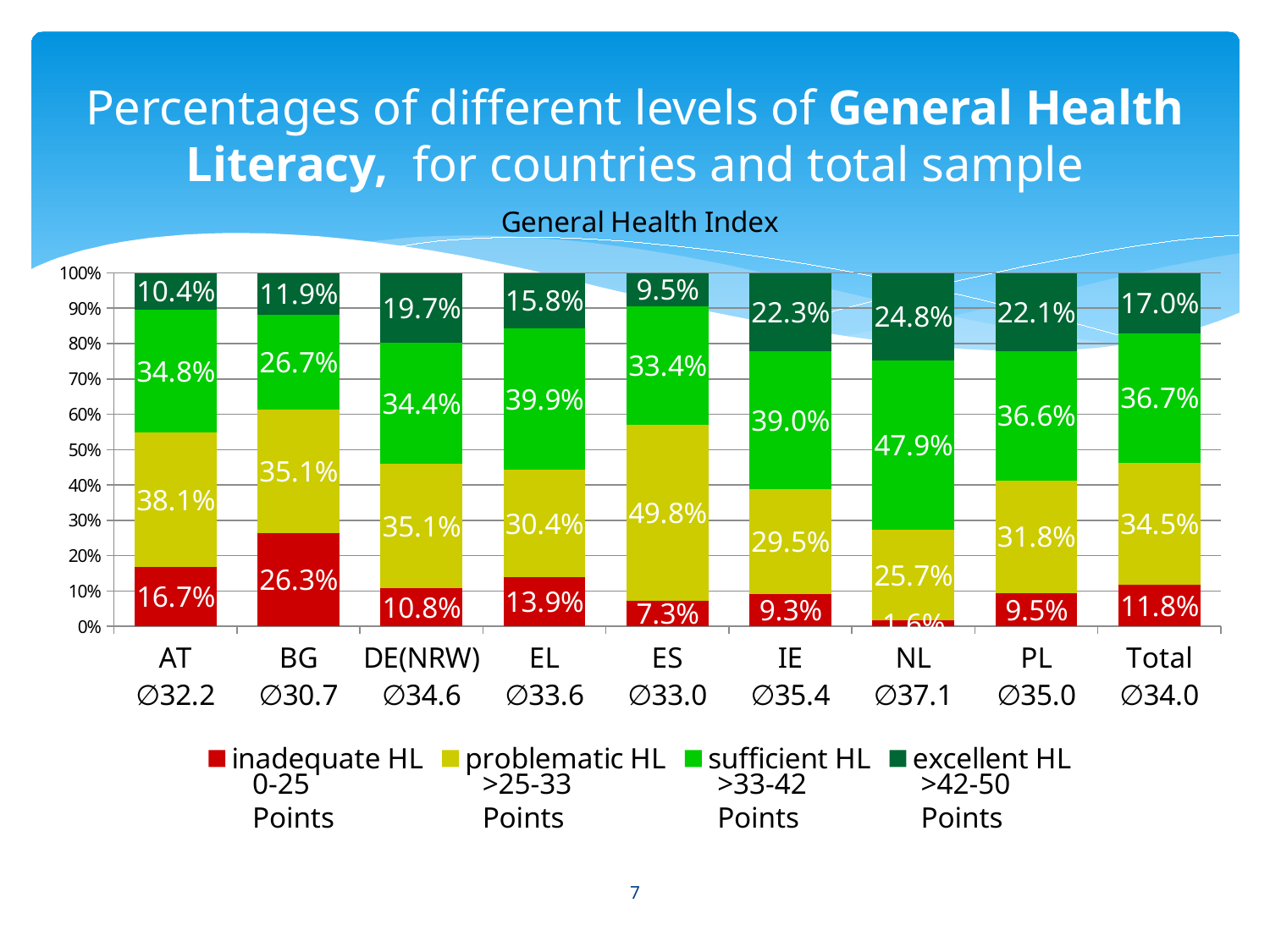
What is the value for excellent HL in NL? 24.8% What percentage of the AT sample has inadequate HL? 16.7% Which is larger, the excellent HL value for IE or for PL? IE Which category has the lowest percentage of excellent HL? ES How many series does the legend list? 4 Which country has the highest percentage of inadequate HL? BG What percentage of the Total sample has sufficient HL? 36.7% What is the problematic HL value for ES? 49.8% What is the difference between the inadequate HL values for BG and AT? 9.6% How many countries/categories are shown on the x axis? 9 Which category has the highest percentage of sufficient HL? NL What kind of chart is shown on the slide? Stacked bar chart